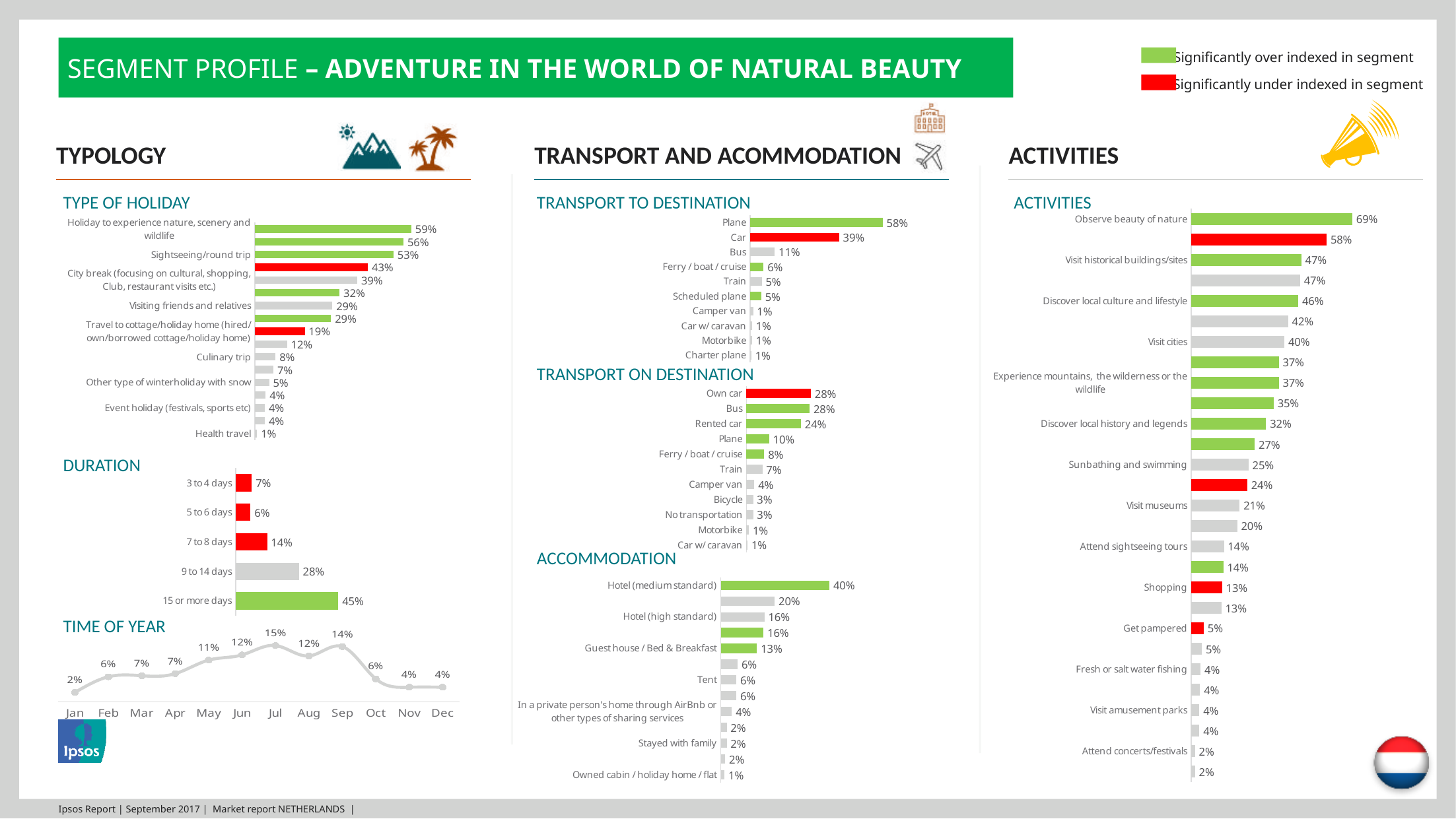
In the Transport to Destination chart, what is the difference between Plane and Car? 19% In the Duration chart, what percentage is shown for 15 or more days? 45% In the Time of Year chart, what is the value for Jan? 2% In the Transport on Destination chart, what is the value for Rented car? 24% In the Duration chart, which duration category has the lowest value? 5 to 6 days In the Accommodation chart, which accommodation type has the highest value? Hotel (medium standard) In the Duration chart, how many duration categories are shown? 5 In the Activities chart, which is larger: Visit cities or Shopping? Visit cities In the Transport to Destination chart, what is the value for Plane? 58% What kind of chart is the Time of Year chart? Line chart In the Time of Year chart, which month has the highest value? Jul In the Activities chart, what is the value for Observe beauty of nature? 69%